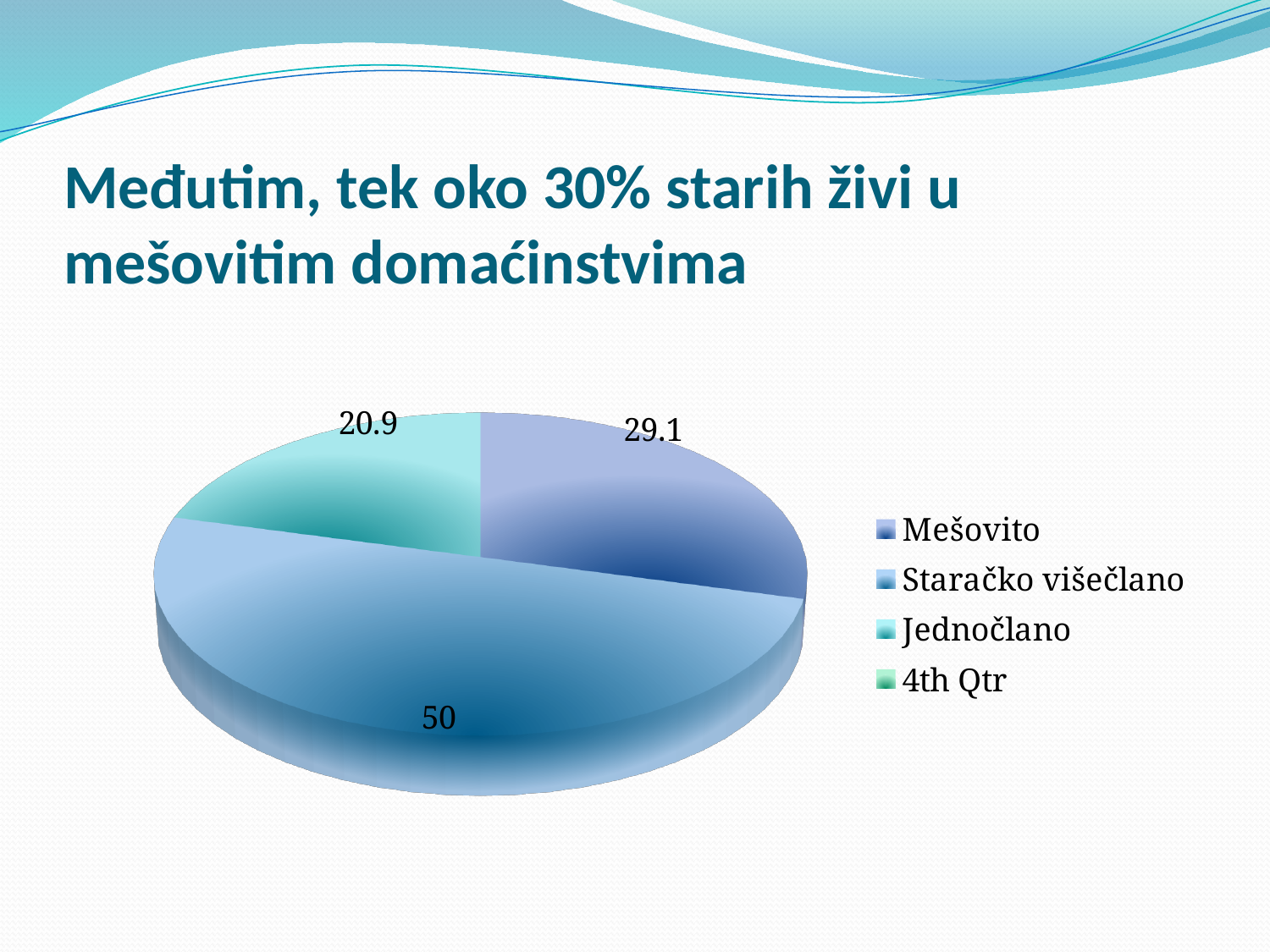
Which is larger, the Mešovito slice or the Jednočlano slice? Mešovito Which labelled category has the smallest slice in the pie chart? Jednočlano How many slices with data labels are visible in the pie chart? 3 How many entries does the legend of the pie chart list? 4 What is the difference between the Staračko višečlano value and the Mešovito value? 20.9 Which category has the largest slice in the pie chart? Staračko višečlano What type of chart is shown on the slide? Pie chart What is the name of the fourth legend entry in the pie chart? 4th Qtr What value is shown for the Mešovito slice of the pie chart? 29.1 What is the difference between the Mešovito value and the Jednočlano value? 8.2 What value is shown for the Jednočlano slice of the pie chart? 20.9 What value is shown for the Staračko višečlano slice of the pie chart? 50